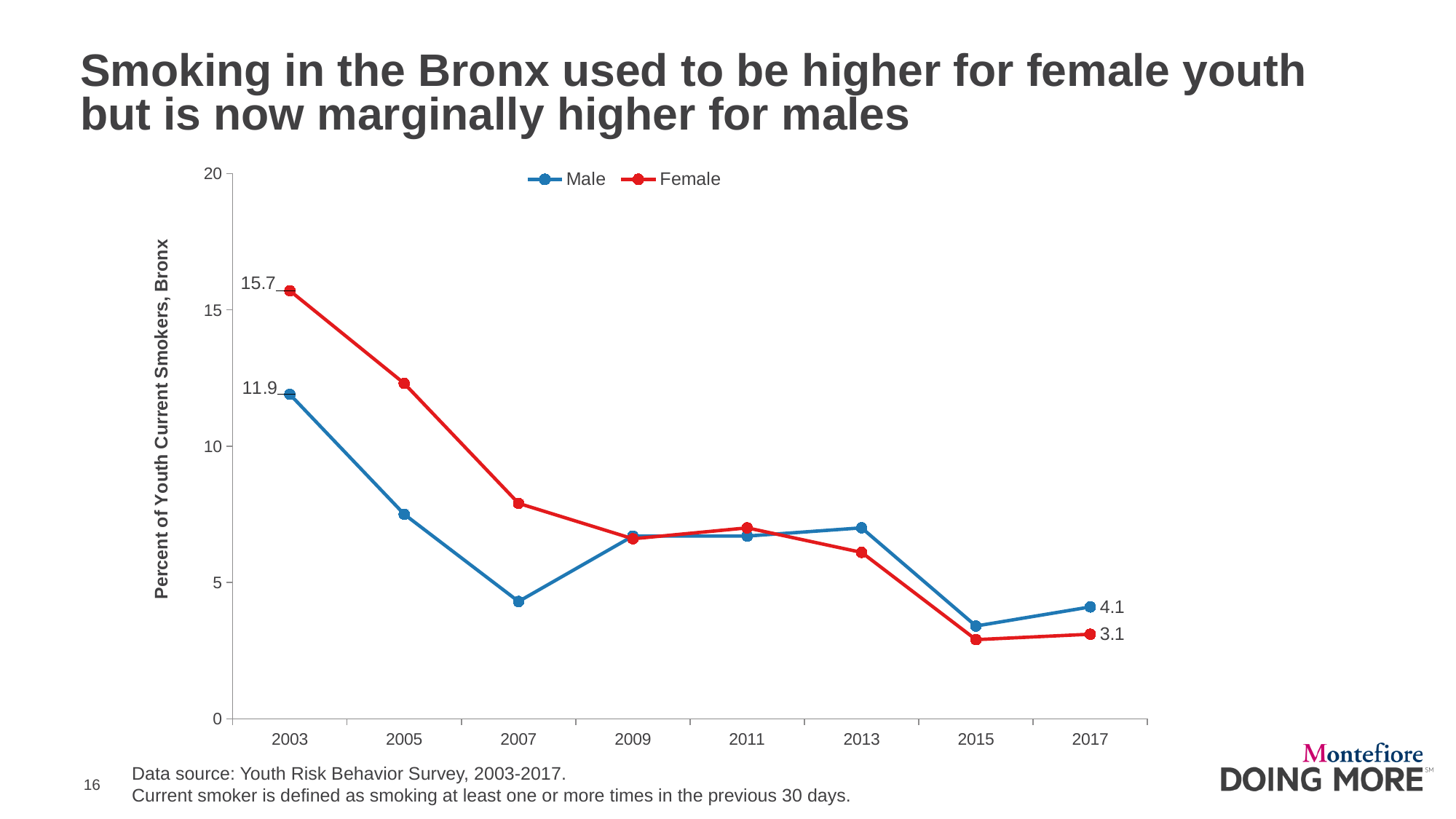
What was the percent of male youth current smokers in the Bronx in 2003? 11.9 Is the value for Male in 2007 greater or less than 5? less Which series had the higher value in 2005, Male or Female? Female What was the percent of female youth current smokers in the Bronx in 2003? 15.7 Is the value for Female in 2005 greater or less than 10? greater What was the percent of male youth current smokers in the Bronx in 2017? 4.1 How many series does the legend list? 2 What kind of chart is shown on the slide? Line chart How many years are shown on the x axis? 8 What is the difference between the female and male values in 2003? 3.8 What is the difference between the male and female values in 2017? 1.0 What was the percent of female youth current smokers in the Bronx in 2017? 3.1